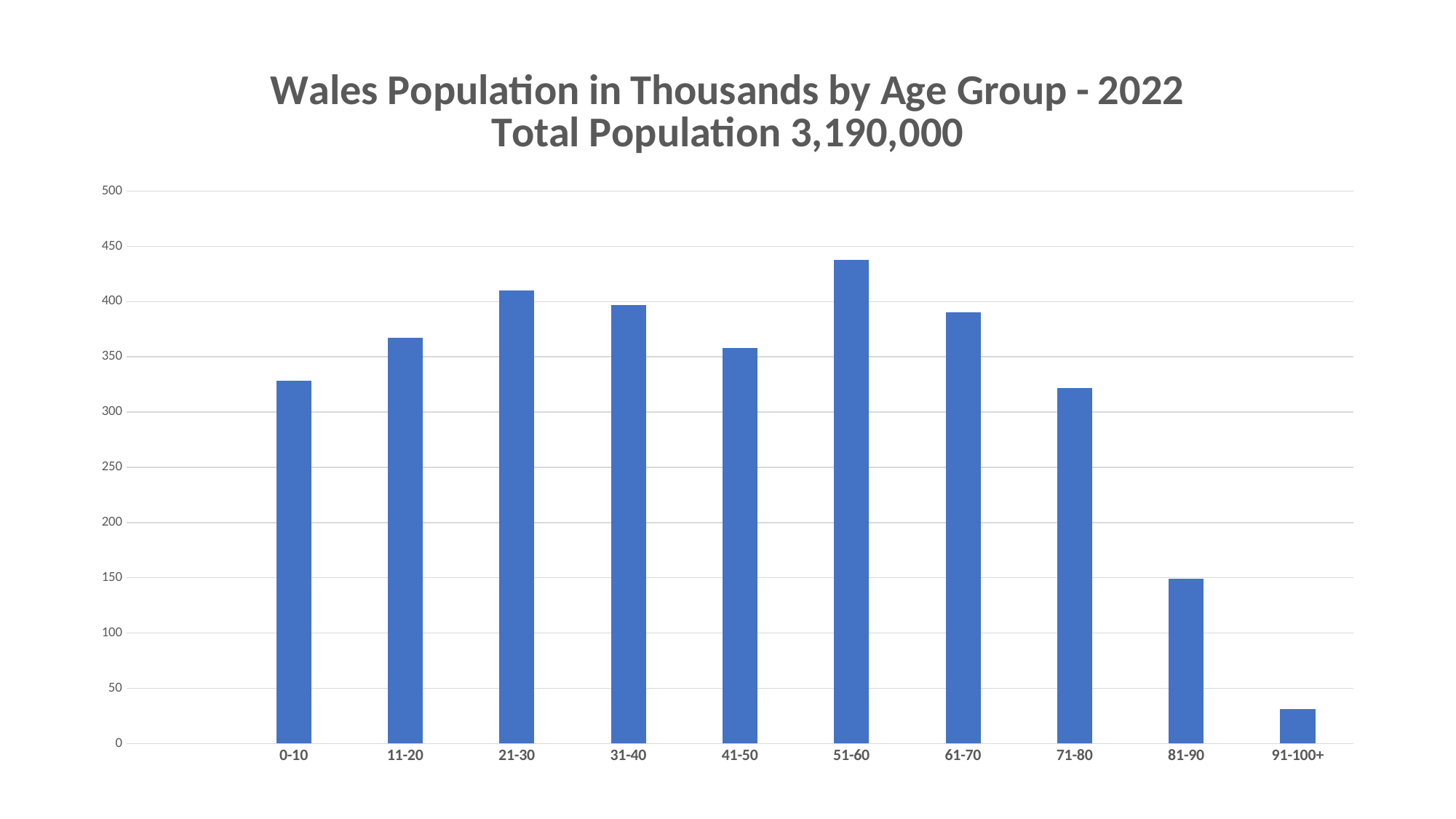
Is the value for the 91-100+ age group greater or less than 50? less Is the value for the 0-10 age group greater or less than 300? greater Which has the larger population, the 51-60 age group or the 61-70 age group? 51-60 Which age group has the highest population? 51-60 Which has the larger population, the 81-90 age group or the 91-100+ age group? 81-90 Do the values rise or fall from the 61-70 age group to the 91-100+ age group? fall Which age group has the lowest population? 91-100+ Is the value for the 51-60 age group greater or less than 450? less What kind of chart is shown on the slide? Bar chart What total population is stated in the chart title? 3,190,000 How many age groups are shown on the x axis? 10